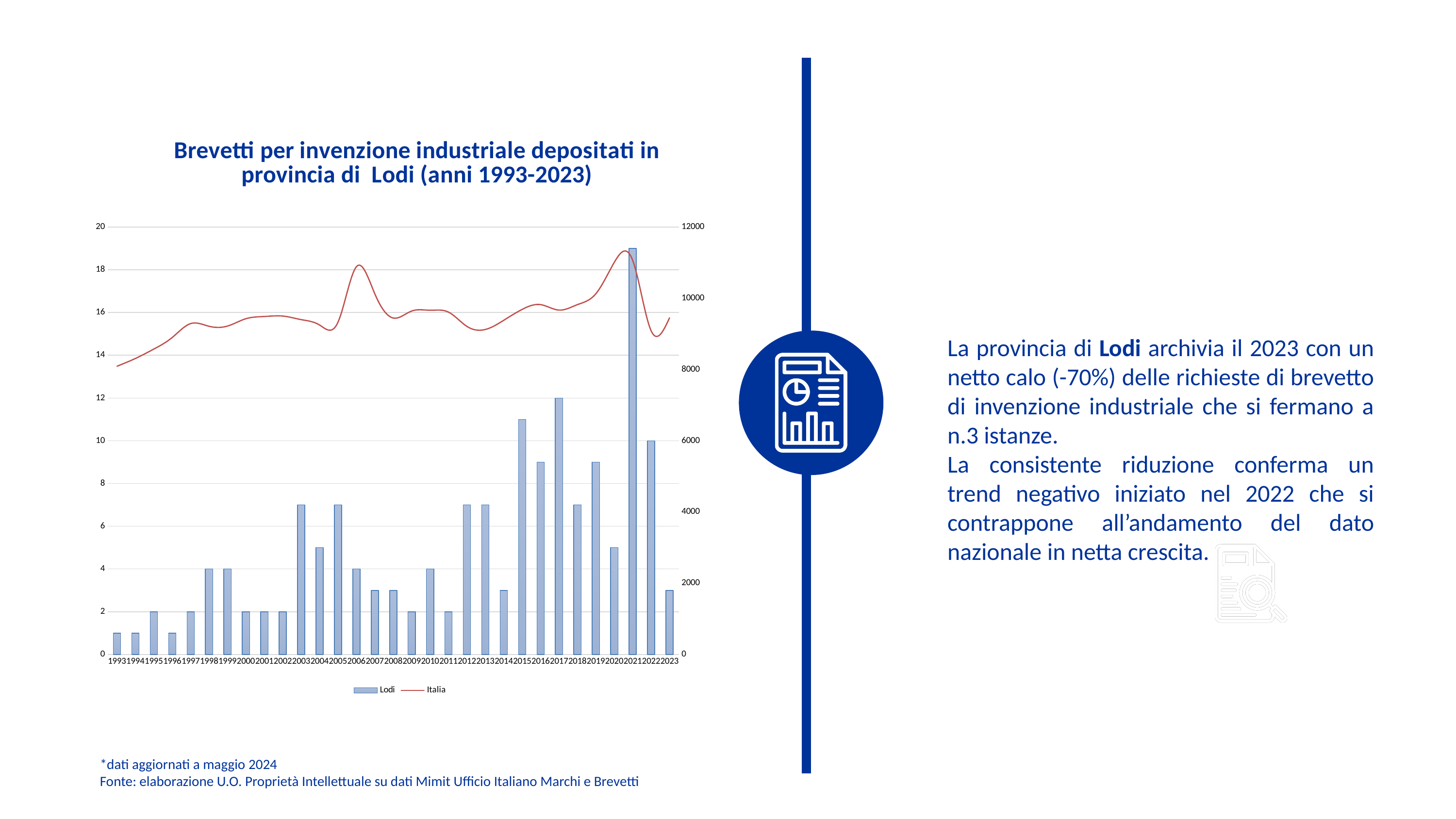
Is the Italia value for 2023 greater or less than 10000? less What is the title of the chart? Brevetti per invenzione industriale depositati in provincia di Lodi (anni 1993-2023) In which year is the Lodi bar highest? 2021 Which is larger, the Lodi value for 2016 or for 2017? 2017 Is the Lodi value for 2021 greater or less than 18? greater What is the Lodi value for 2022? 10 Which series is drawn as a line rather than bars? Italia What is the Lodi value for 2023? 3 How many series does the legend list? 2 What is the Lodi value for 2017? 12 What is the difference between the Lodi values for 2017 and 2022? 2 How many years are shown on the x axis? 31